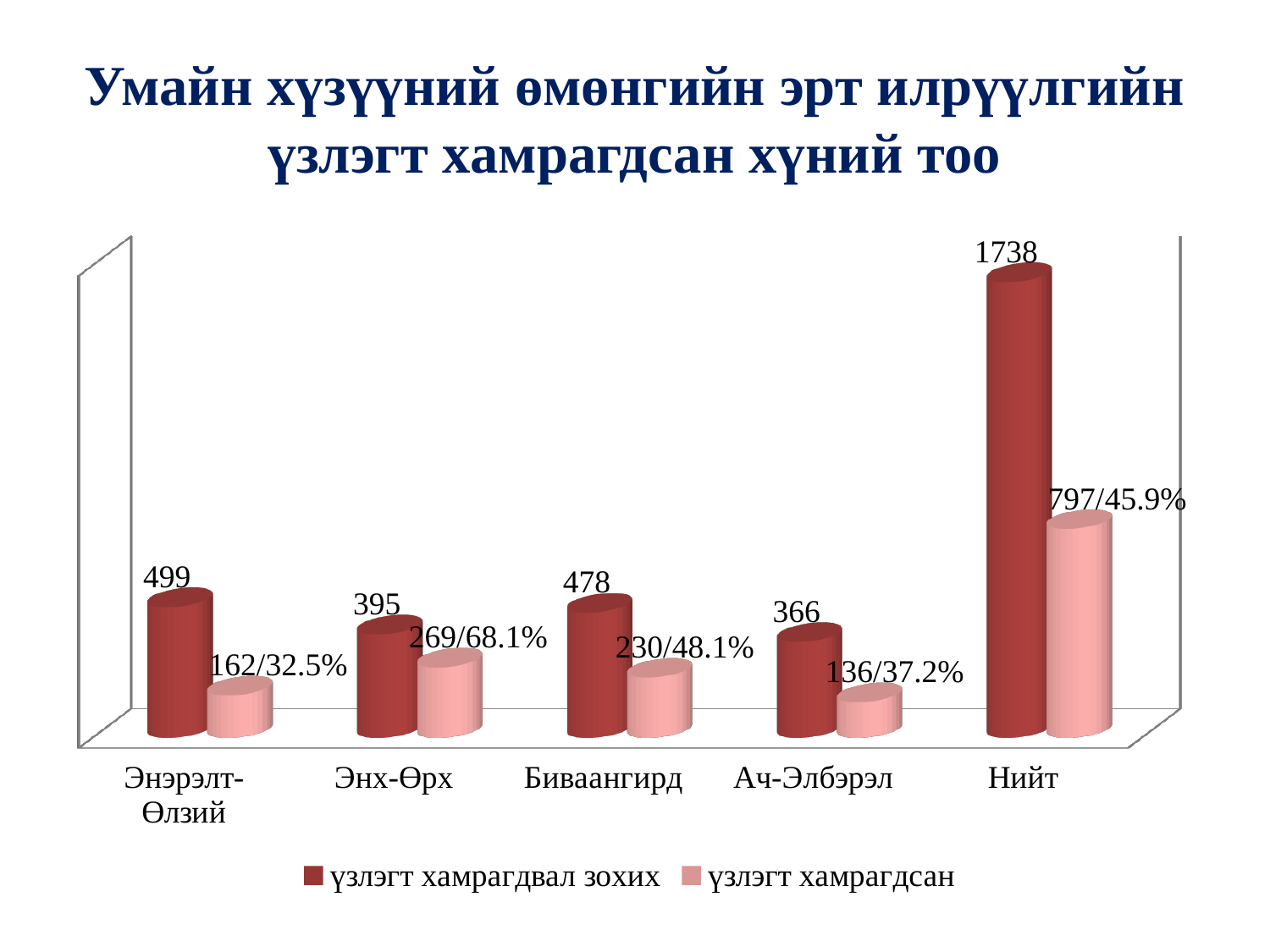
Which legend entry is shown in the lighter pink colour? үзлэгт хамрагдсан How many series does the legend list? 2 What is the difference between the 'үзлэгт хамрагдвал зохих' value and the 'үзлэгт хамрагдсан' count for Биваангирд? 248 What data label is shown on the 'үзлэгт хамрагдсан' bar for Энх-Өрх? 269/68.1% Excluding Нийт, which category has the highest 'үзлэгт хамрагдвал зохих' value? Энэрэлт-Өлзий How many categories are shown on the x axis? 5 What is the value of the 'үзлэгт хамрагдвал зохих' series for Энэрэлт-Өлзий? 499 What data label is shown on the 'үзлэгт хамрагдсан' bar for Ач-Элбэрэл? 136/37.2% Which is larger: the 'үзлэгт хамрагдсан' count for Энх-Өрх or for Биваангирд? Энх-Өрх What kind of chart is shown on the slide? Bar chart Excluding Нийт, which category has the lowest 'үзлэгт хамрагдсан' value? Ач-Элбэрэл What is the value of the 'үзлэгт хамрагдвал зохих' series for Нийт? 1738